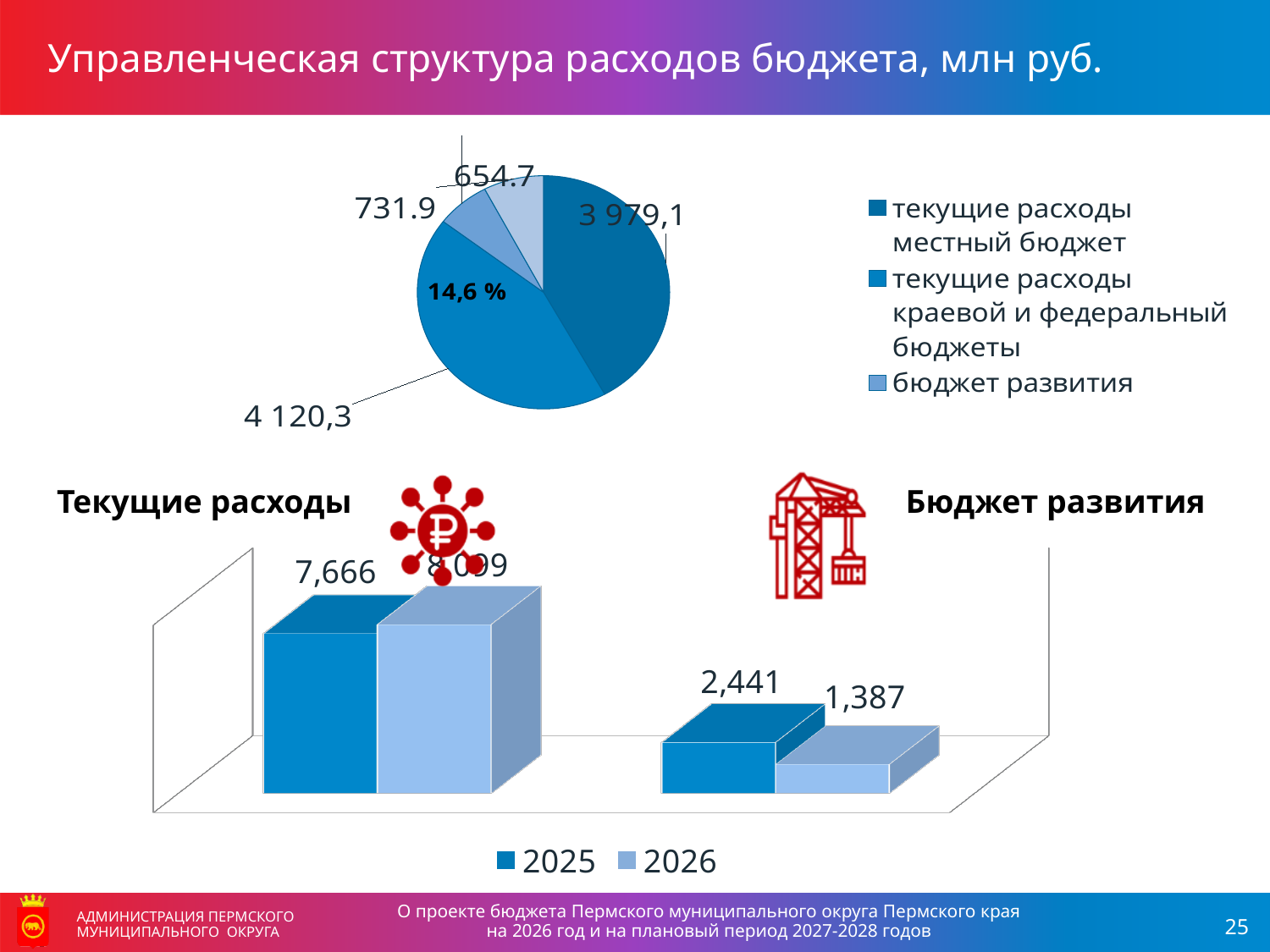
In the bottom bar chart, which year has the larger value for Текущие расходы, 2025 or 2026? 2026 In the bottom bar chart, what is the value for Текущие расходы in 2025? 7,666 In the bottom bar chart, what is the difference between the 2025 and 2026 values for Бюджет развития? 1,054 In the bottom bar chart, what is the value for Бюджет развития in 2026? 1,387 How many series does the legend of the bottom bar chart list? 2 What kind of chart is the top chart on the slide? pie chart In the bottom bar chart, what is the value for Бюджет развития in 2025? 2,441 In the pie chart, which labelled value is the smallest? 654.7 How many entries does the legend of the pie chart list? 3 In the pie chart, what is the value of the slice labelled for the dark blue segment at the top right? 3 979,1 In the pie chart, what percentage is printed inside the pie? 14,6 % In the pie chart, which labelled value is the largest? 4 120,3